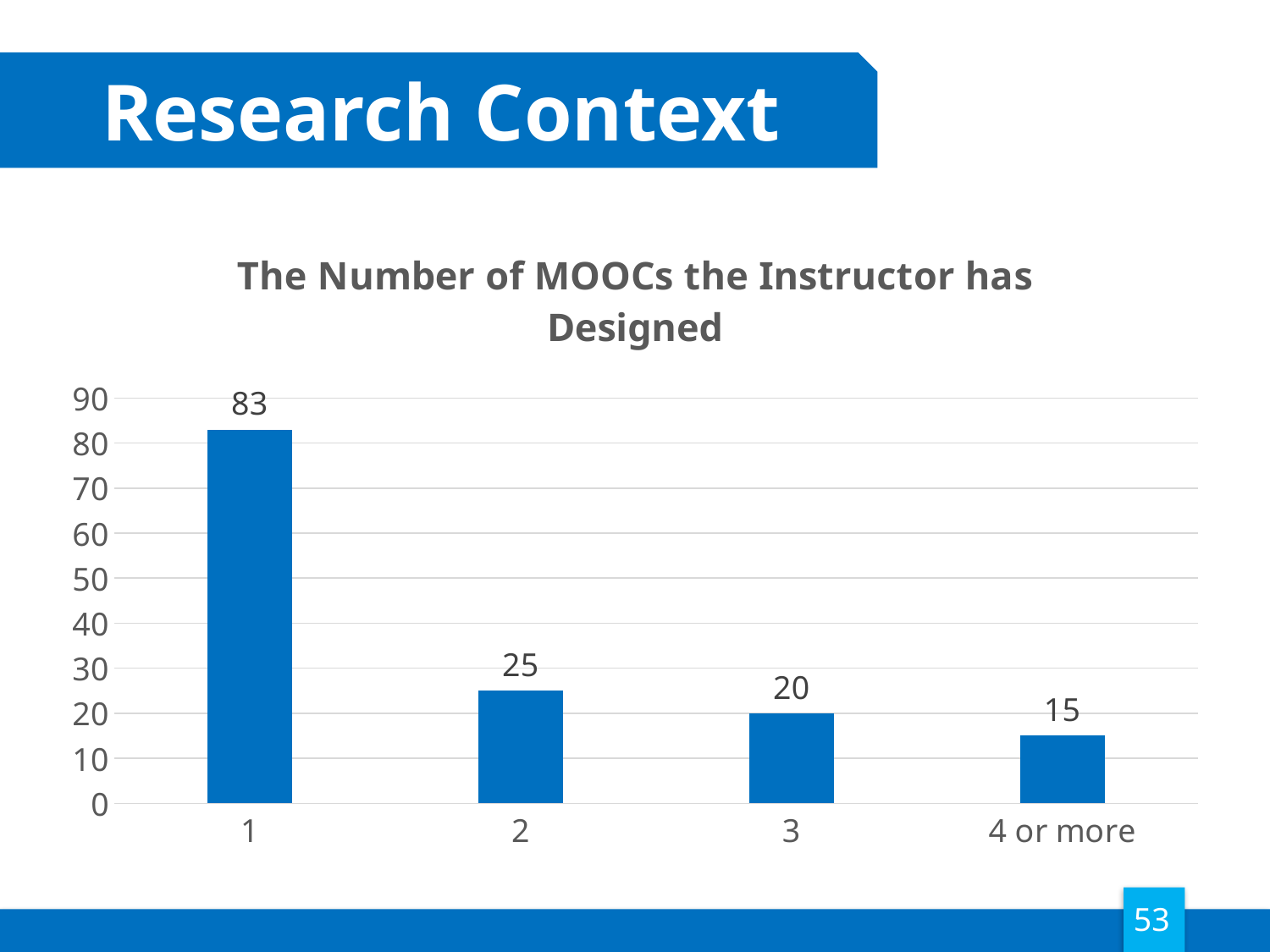
How many categories are shown on the x axis? 4 Which is larger, the value for "2" or the value for "3"? 2 Which category has the lowest value? 4 or more Which category has the highest value? 1 What is the value for the category "3"? 20 What kind of chart is shown on the slide? bar chart What is the difference between the values for "1" and "2"? 58 What is the title of the chart? The Number of MOOCs the Instructor has Designed What is the value for the category "1"? 83 What is the difference between the values for "3" and "4 or more"? 5 What is the value for the category "4 or more"? 15 Is the value for "1" greater or less than 80? greater